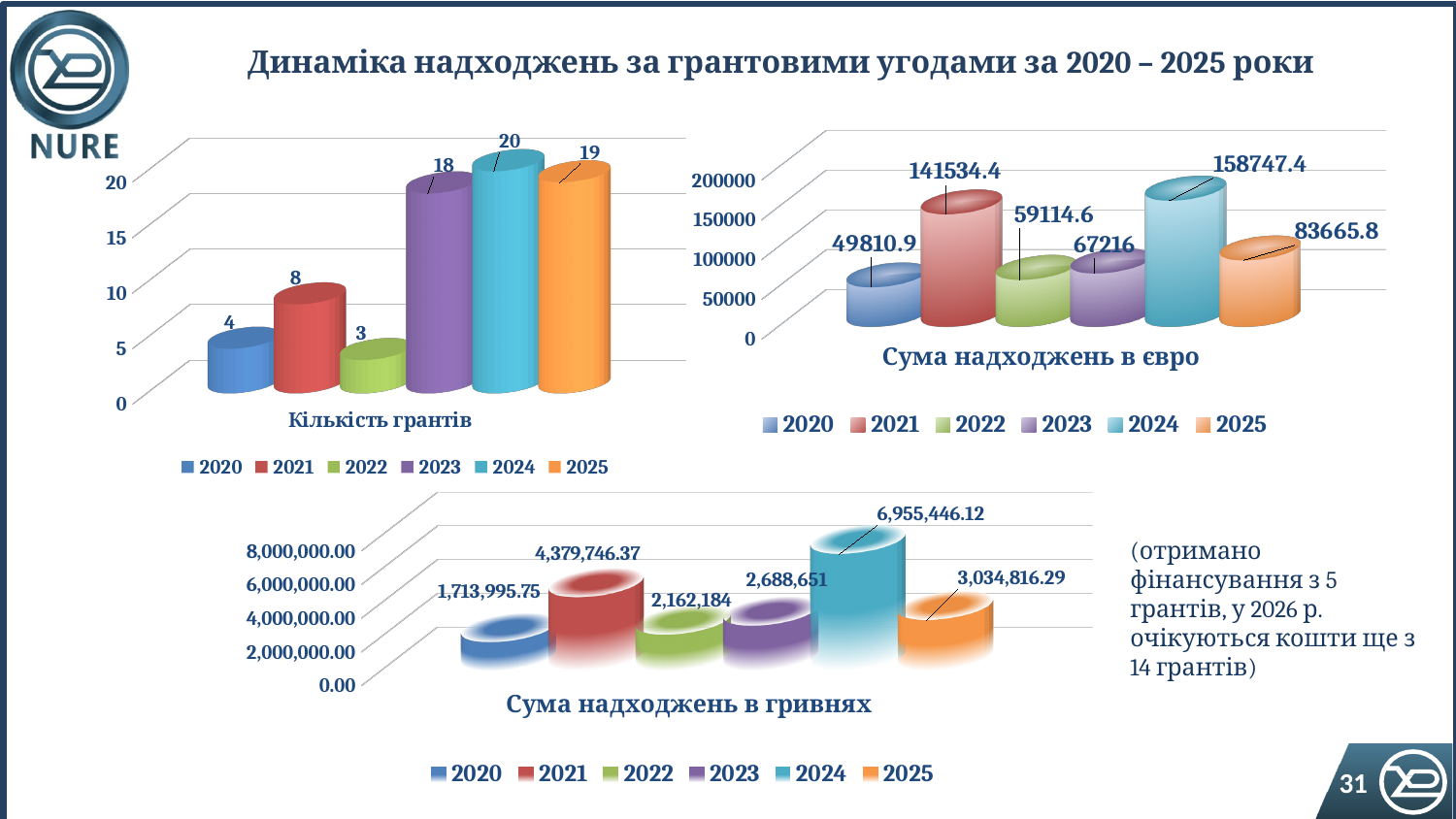
In the chart titled "Сума надходжень в євро", which year has the highest value? 2024 In the chart titled "Кількість грантів", which year has the lowest value? 2022 In the chart titled "Кількість грантів", what is the difference between the values for 2024 and 2020? 16 In the chart titled "Сума надходжень в євро", what is the value for 2021? 141534.4 In the chart titled "Кількість грантів", which year has the highest value? 2024 In the chart titled "Сума надходжень в євро", which is larger, the value for 2022 or the value for 2023? 2023 In the chart titled "Сума надходжень в євро", is the value for 2025 greater or less than 100000? less In the chart titled "Сума надходжень в гривнях", what is the value for 2024? 6,955,446.12 In the chart titled "Сума надходжень в гривнях", which year has the lowest value? 2020 In the chart titled "Кількість грантів", what is the value for 2023? 18 What kind of chart is the chart titled "Кількість грантів"? bar chart How many series does the legend of the chart titled "Сума надходжень в гривнях" list? 6